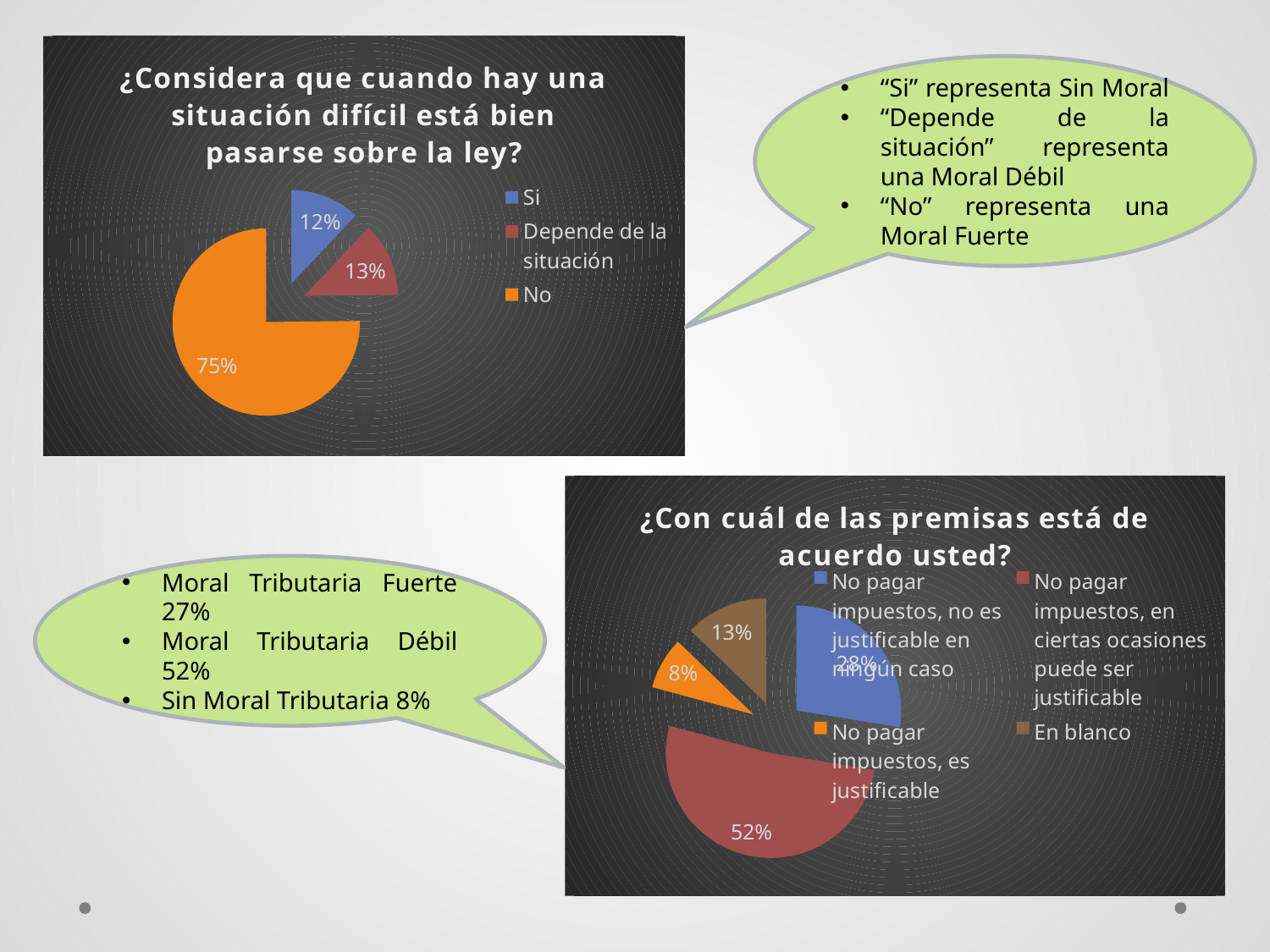
In the chart titled "¿Considera que cuando hay una situación difícil está bien pasarse sobre la ley?", what is the value for "Si"? 12% In the chart titled "¿Considera que cuando hay una situación difícil está bien pasarse sobre la ley?", what is the value for "Depende de la situación"? 13% In the chart titled "¿Considera que cuando hay una situación difícil está bien pasarse sobre la ley?", what is the difference between the "No" and "Si" values? 63% In the chart titled "¿Considera que cuando hay una situación difícil está bien pasarse sobre la ley?", what share of the pie is "No"? 75% In the chart titled "¿Con cuál de las premisas está de acuerdo usted?", which is larger: "En blanco" or "No pagar impuestos, es justificable"? En blanco In the chart titled "¿Considera que cuando hay una situación difícil está bien pasarse sobre la ley?", how many categories does the legend list? 3 What kind of chart is the one titled "¿Con cuál de las premisas está de acuerdo usted?"? Pie chart In the chart titled "¿Con cuál de las premisas está de acuerdo usted?", what is the value for "No pagar impuestos, en ciertas ocasiones puede ser justificable"? 52% In the chart titled "¿Considera que cuando hay una situación difícil está bien pasarse sobre la ley?", which category has the largest slice? No In the chart titled "¿Con cuál de las premisas está de acuerdo usted?", which category has the smallest slice? No pagar impuestos, es justificable In the chart titled "¿Considera que cuando hay una situación difícil está bien pasarse sobre la ley?", which category has the smallest slice? Si In the chart titled "¿Con cuál de las premisas está de acuerdo usted?", what is the value for "En blanco"? 13%